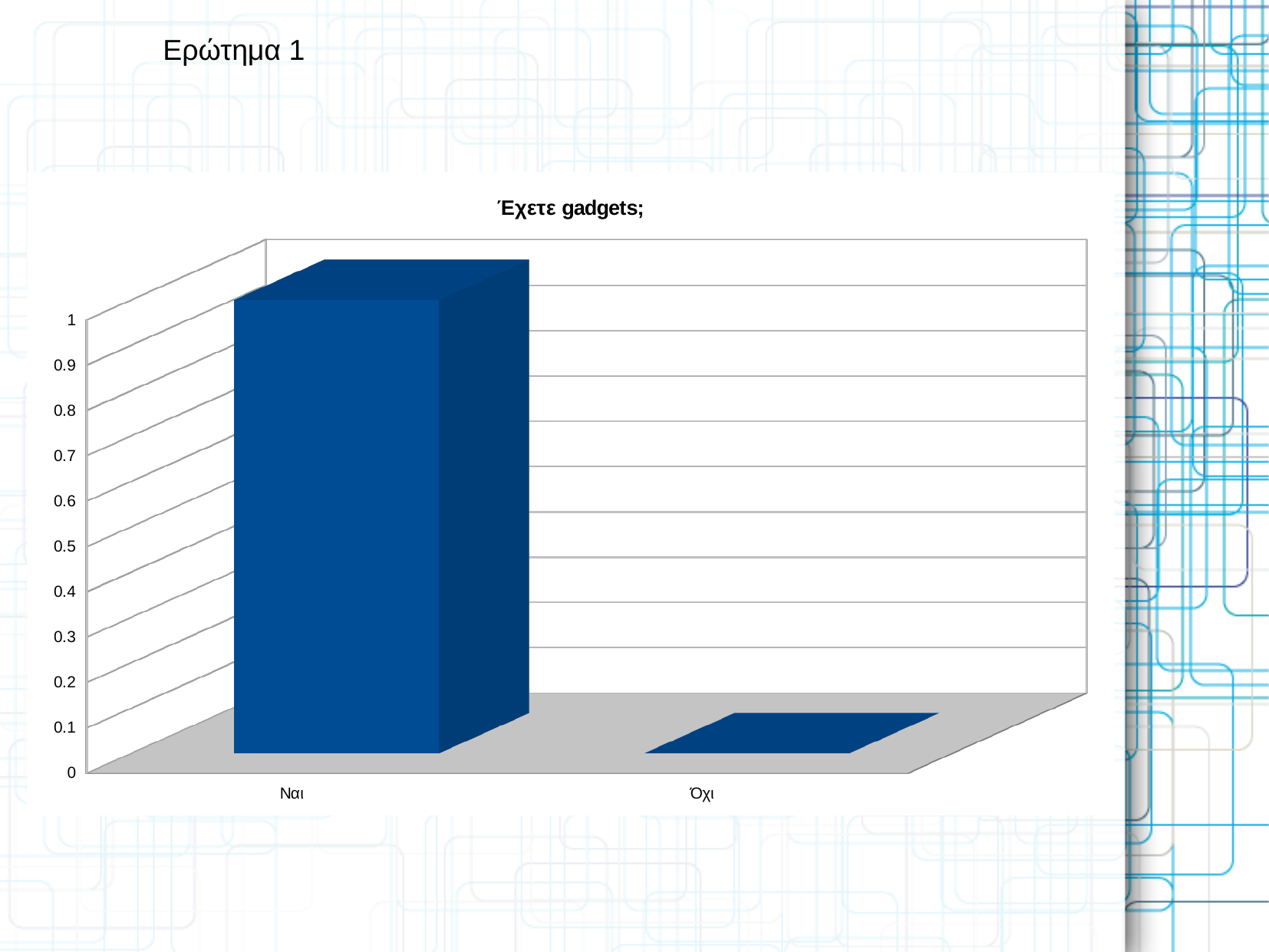
Which is larger, the value for Ναι or the value for Όχι? Ναι Do the values rise or fall going from Ναι to Όχι along the x axis? fall What is the value for Όχι in the chart? 0 Which category has the lowest value in the chart? Όχι Is the value for Ναι greater or less than 0.5? greater What kind of chart is shown on the slide? bar chart Which category has the highest value in the chart? Ναι How many categories are shown on the x axis of the chart? 2 What is the title of the chart? Έχετε gadgets; What is the highest tick value shown on the vertical axis of the chart? 1 Is the value for Όχι greater or less than 0.1? less